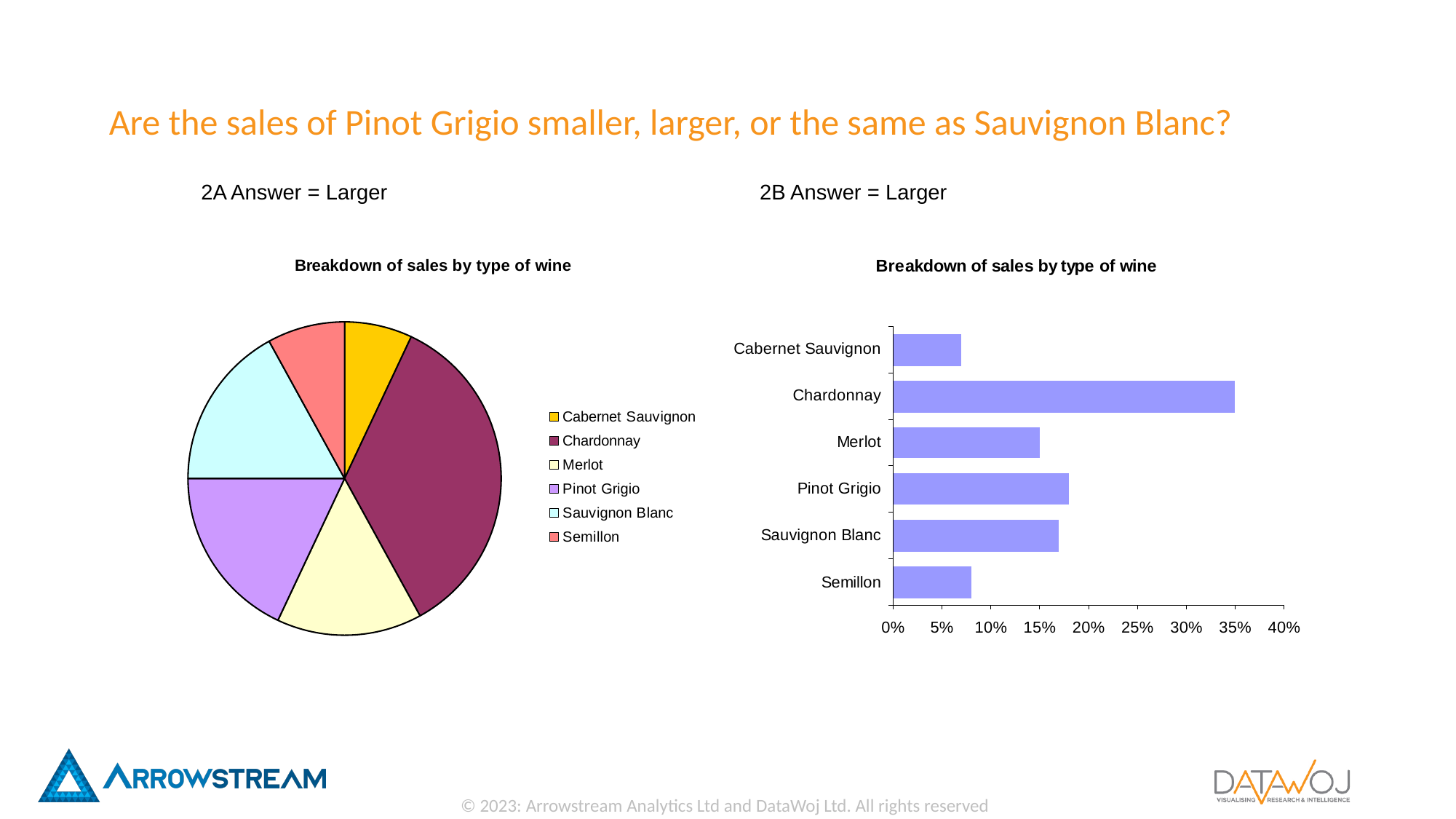
In the right bar chart, is the value for Semillon greater or less than 10%? less In the left pie chart, how many slices are there? 6 In the right bar chart, which is larger: the value for Pinot Grigio or the value for Sauvignon Blanc? Pinot Grigio In the left pie chart, which wine type has the largest slice? Chardonnay What is the title of the left pie chart? Breakdown of sales by type of wine In the right bar chart, is the value for Cabernet Sauvignon greater or less than 10%? less In the right bar chart, which wine type has the highest share of sales? Chardonnay In the right bar chart, how many wine types are plotted? 6 What kind of chart is the left chart on the slide? pie chart In the right bar chart, what is the value for Chardonnay? 35% In the right bar chart, is the value for Pinot Grigio greater or less than 15%? greater What kind of chart is the right chart on the slide? bar chart